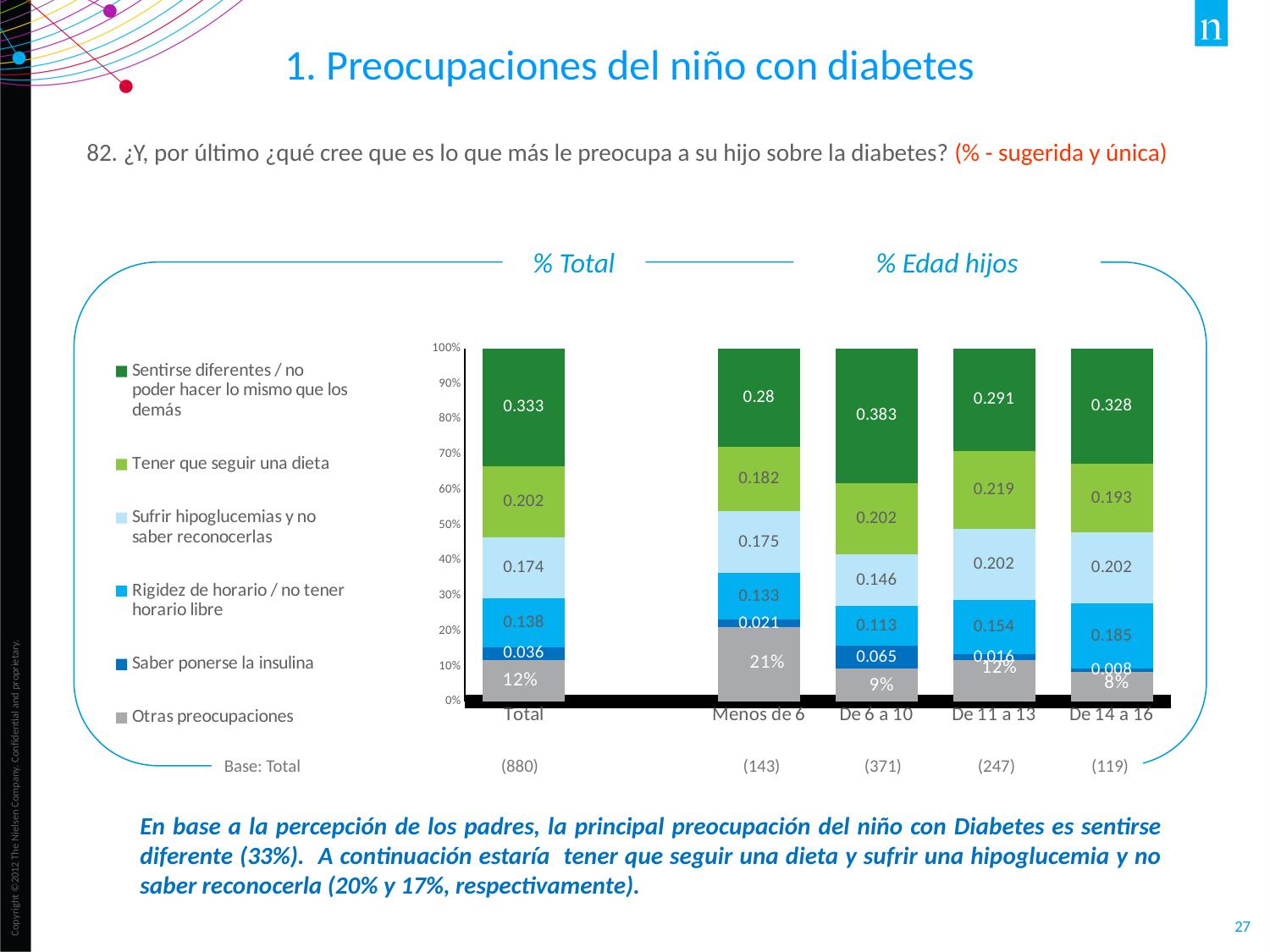
What is the value for "Sentirse diferentes / no poder hacer lo mismo que los demás" in the "De 6 a 10" bar? 0.383 What is the value for "Tener que seguir una dieta" in the "De 11 a 13" bar? 0.219 How many categories are shown on the x axis of the chart? 5 Which category has the highest value for "Sentirse diferentes / no poder hacer lo mismo que los demás"? De 6 a 10 What is the value for "Sentirse diferentes / no poder hacer lo mismo que los demás" in the Total bar? 0.333 What is the difference between the "Sentirse diferentes / no poder hacer lo mismo que los demás" values for "De 6 a 10" and Total? 0.05 What is the value for "Otras preocupaciones" in the "Menos de 6" bar? 21% Which category has the lowest value for "Sentirse diferentes / no poder hacer lo mismo que los demás"? Menos de 6 What is the value for "Sufrir hipoglucemias y no saber reconocerlas" in the "Menos de 6" bar? 0.175 What is the value for "Saber ponerse la insulina" in the Total bar? 0.036 How many series does the legend list? 6 Which is larger for "Rigidez de horario / no tener horario libre": Total or "De 11 a 13"? De 11 a 13